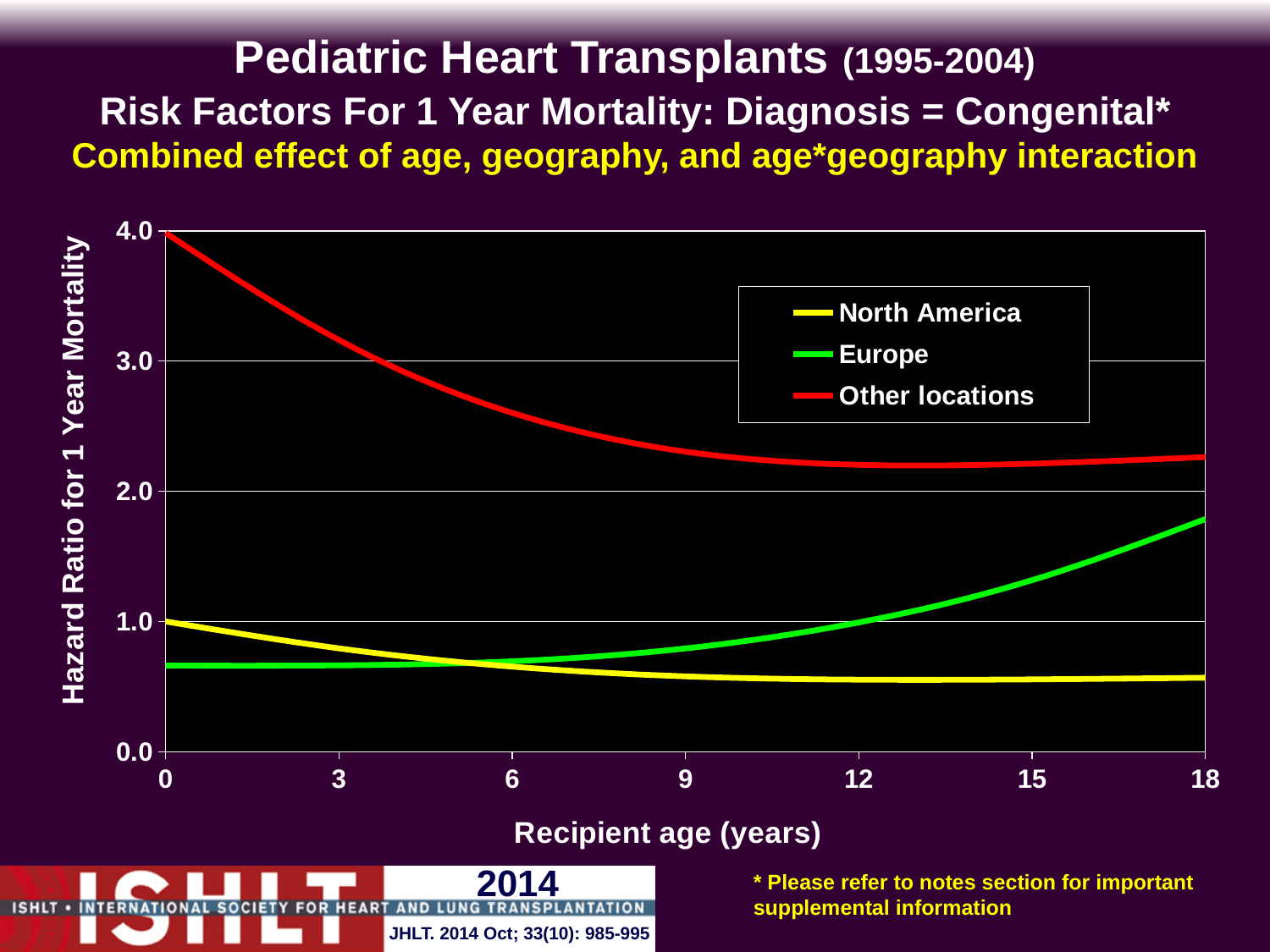
Is the hazard ratio for Europe at age 18 greater or less than 1.0? greater How many series does the legend list? 3 At age 0, which has the higher hazard ratio, North America or Europe? North America Does the hazard ratio for Europe rise or fall between age 6 and age 18? rise What is the title of the x axis? Recipient age (years) Is the hazard ratio for Other locations at age 0 greater or less than 3.0? greater Is the hazard ratio for North America at age 18 greater or less than 1.0? less At age 18, which has the higher hazard ratio, Europe or North America? Europe Which series has the highest hazard ratio at age 9? Other locations Which series is drawn in green? Europe What kind of chart is shown on the slide? line chart